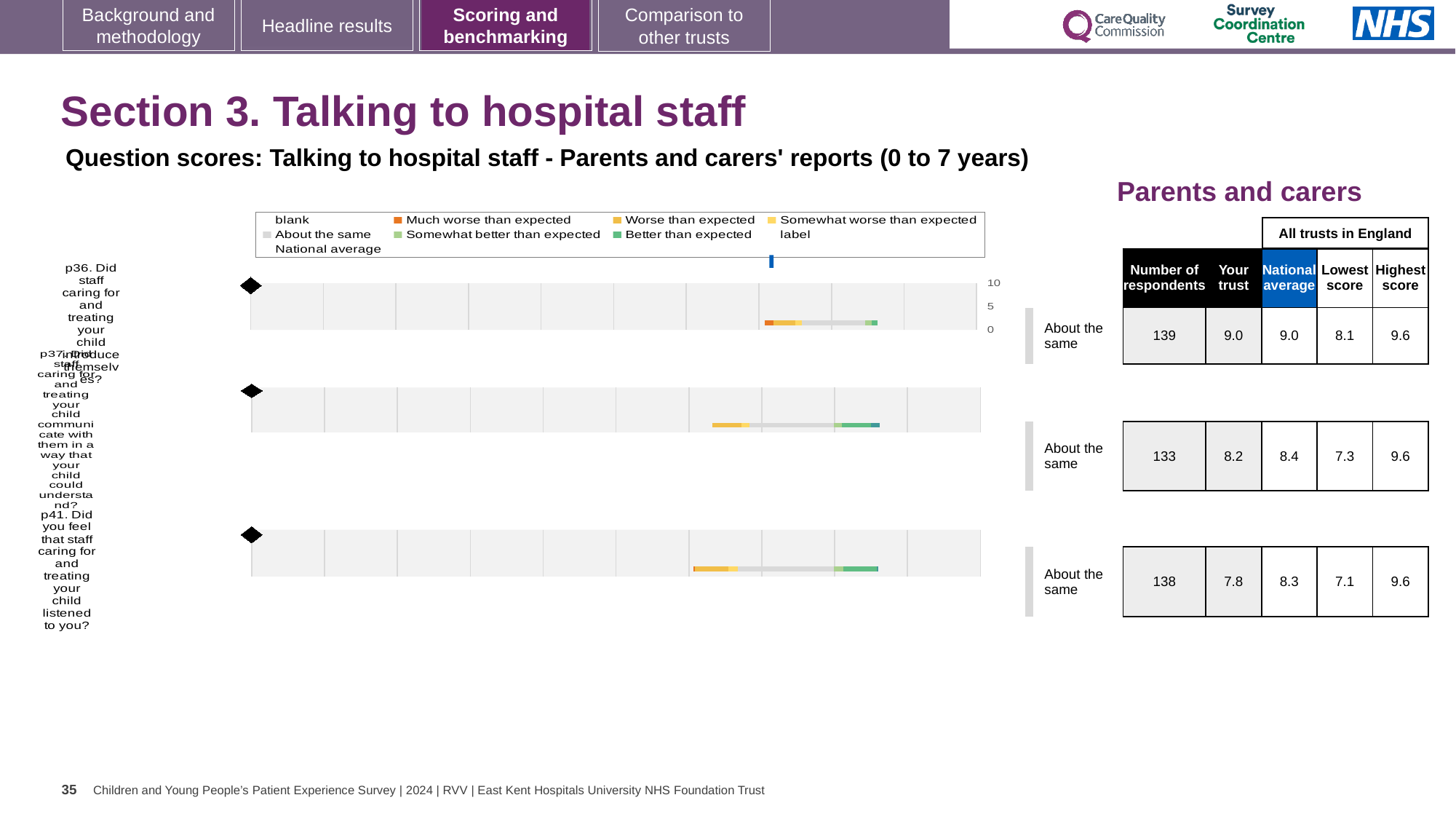
What is the 'Your trust' score for p36 (Did staff caring for and treating your child introduce themselves?)? 9.0 Which of the three questions has the fewest respondents? p37 How many respondents answered p36? 139 What is the 'Your trust' score for p41 (Did you feel that staff listened to you?)? 7.8 What is the lowest score among all trusts in England for p41? 7.1 Which of the three questions has the highest 'Your trust' score? p36 How many survey questions (rows) are plotted in the charts on this slide? 3 What benchmark category is shown next to each of the three question charts? About the same What is the national average score for p37 (Did staff communicate with your child in a way they could understand?)? 8.4 What is the difference between the highest score (9.6) and the lowest score (7.1) for p41? 2.5 What kind of chart is used to show the question scores on this slide? bar chart Is the 'Your trust' score for p37 larger or smaller than the national average for p37? smaller